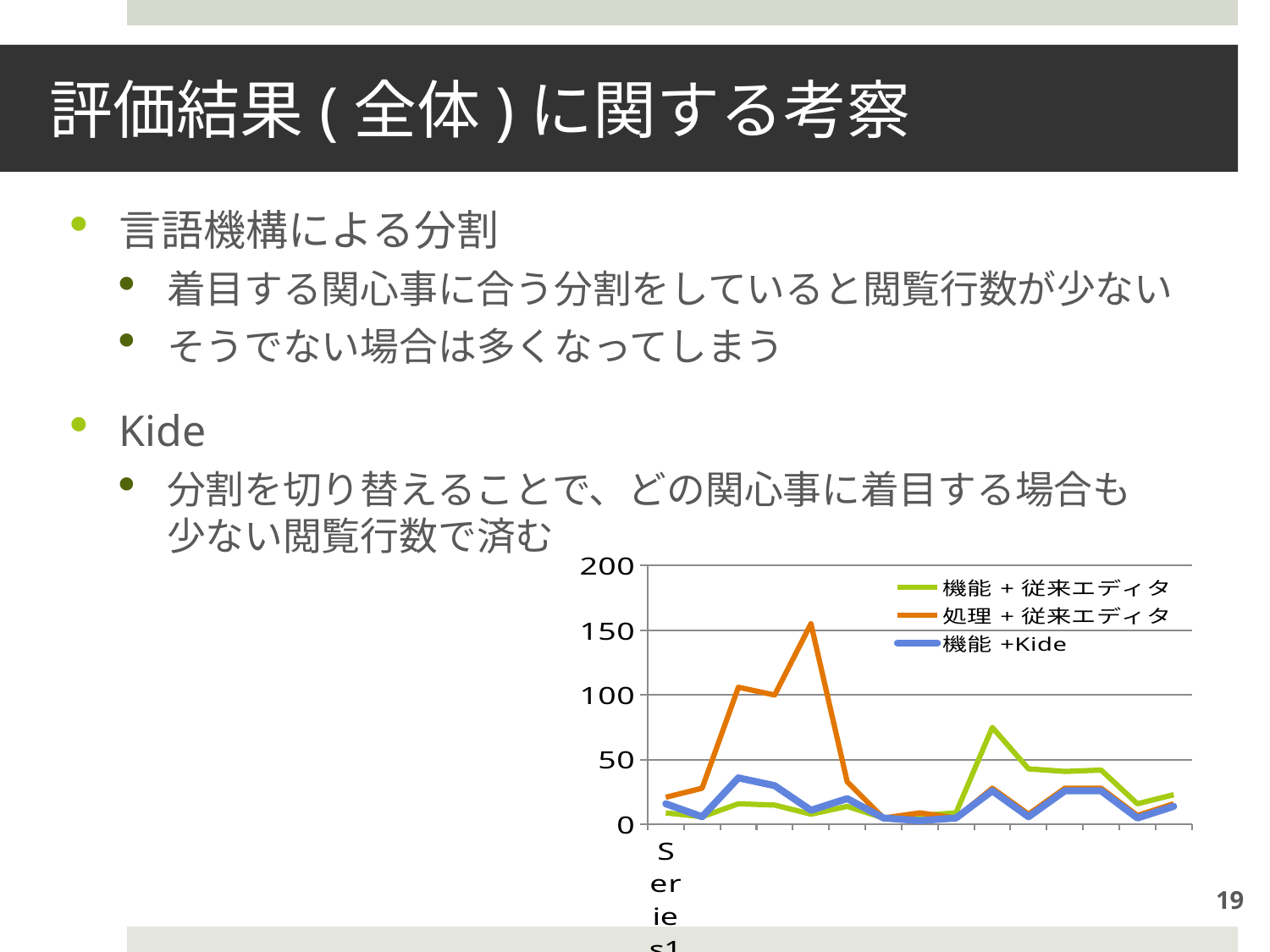
Which series has the lowest peak value on the chart? 機能＋Kide What colour is the line for the 機能＋Kide series? blue Is the highest value of the 処理＋従来エディタ series greater or less than 100? greater Is the highest value of the 機能＋従来エディタ series greater or less than 50? greater Which series has the higher peak, 処理＋従来エディタ or 機能＋Kide? 処理＋従来エディタ What kind of chart is shown on the slide? line chart Which series reaches the highest value anywhere on the chart? 処理＋従来エディタ Is the highest value of the 機能＋Kide series greater or less than 50? less How many series does the chart's legend list? 3 What is the highest value shown on the chart's vertical axis? 200